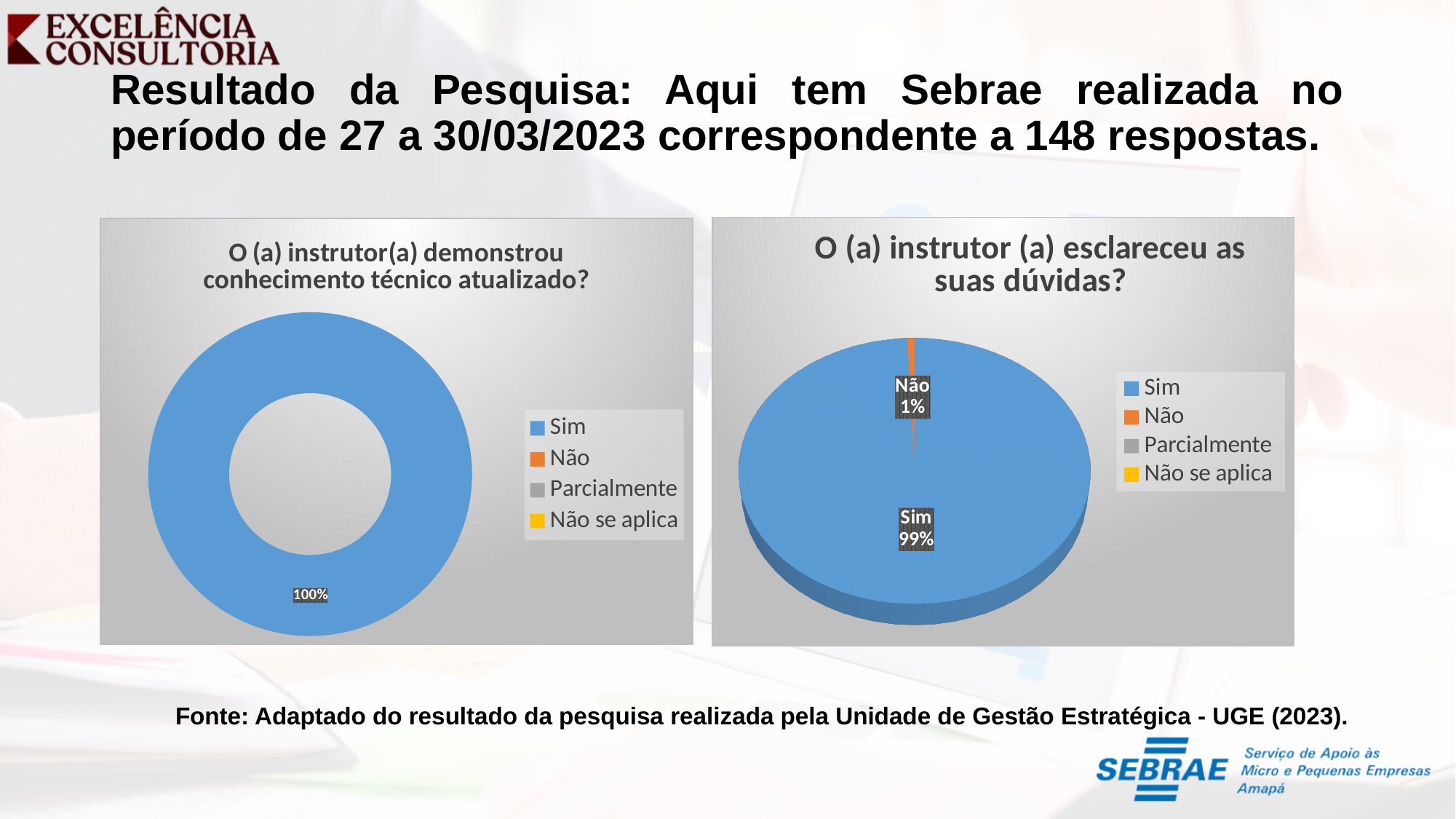
What kind of chart is the one on the left of the slide, titled "O (a) instrutor(a) demonstrou conhecimento técnico atualizado?"? doughnut chart How many charts are shown on the slide? 2 In the chart titled "O (a) instrutor(a) demonstrou conhecimento técnico atualizado?", what share is shown for Sim? 100% In the chart titled "O (a) instrutor (a) esclareceu as suas dúvidas?", what share is shown for Sim? 99% In the chart titled "O (a) instrutor (a) esclareceu as suas dúvidas?", what is the difference in percentage points between Sim and Não? 98 In the chart titled "O (a) instrutor (a) esclareceu as suas dúvidas?", what colour is the Não slice? orange In the chart titled "O (a) instrutor (a) esclareceu as suas dúvidas?", is the share for Sim larger or smaller than the share for Não? larger In the chart titled "O (a) instrutor (a) esclareceu as suas dúvidas?", which category has the largest slice? Sim In the chart titled "O (a) instrutor (a) esclareceu as suas dúvidas?", which of the two labelled slices is smaller, Sim or Não? Não In the chart titled "O (a) instrutor (a) esclareceu as suas dúvidas?", what share is shown for Não? 1% What kind of chart is the one on the right of the slide, titled "O (a) instrutor (a) esclareceu as suas dúvidas?"? pie chart How many entries does the legend of the chart titled "O (a) instrutor(a) demonstrou conhecimento técnico atualizado?" list? 4